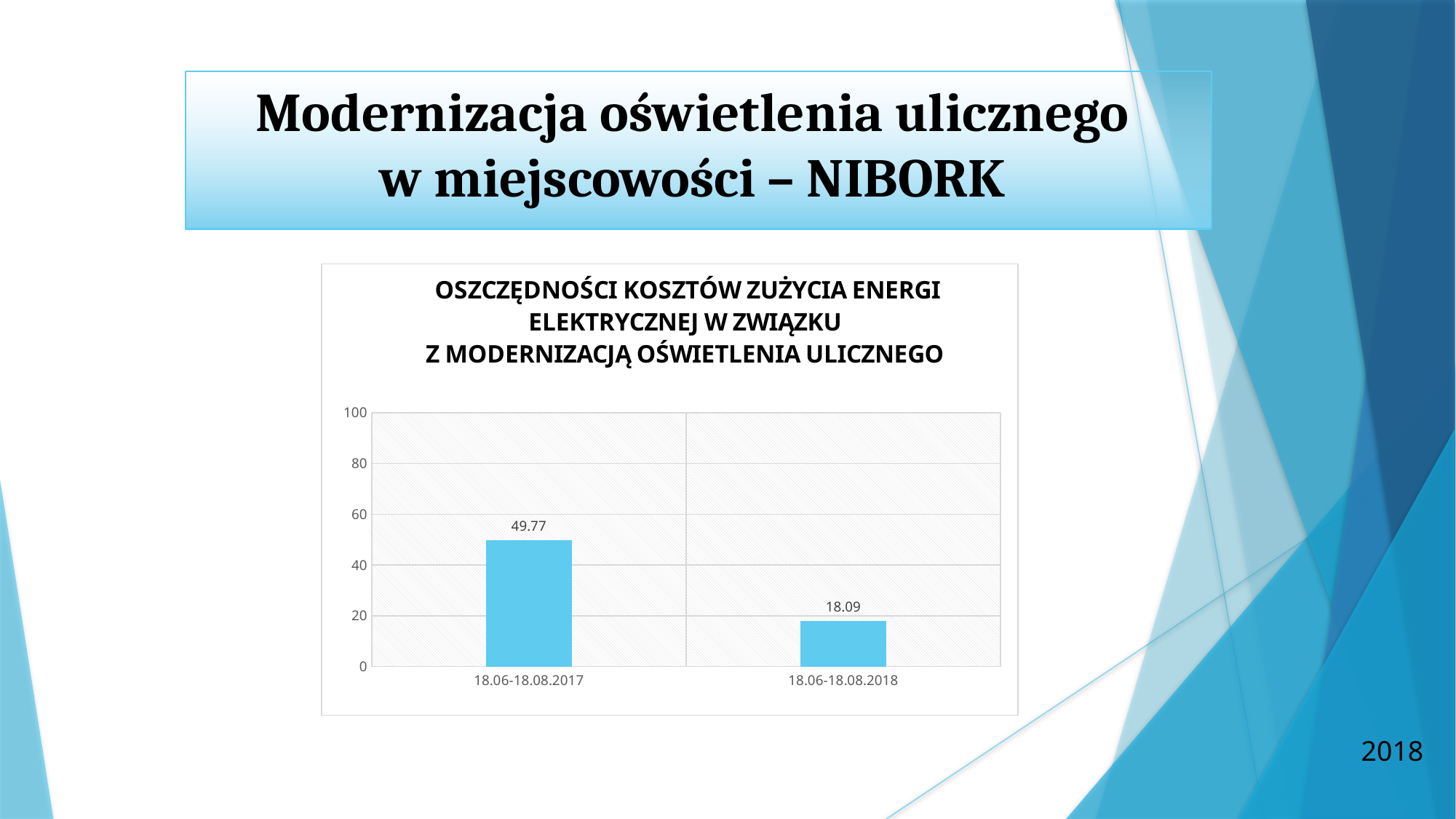
Is the value for 18.06-18.08.2018 greater or less than 20? less What is the difference between the values for 18.06-18.08.2017 and 18.06-18.08.2018? 31.68 Do the values rise or fall from 18.06-18.08.2017 to 18.06-18.08.2018? fall Is the value for 18.06-18.08.2017 greater or less than 40? greater What is the value for 18.06-18.08.2017? 49.77 What is the maximum value shown on the vertical axis? 100 Which category has the lowest value? 18.06-18.08.2018 Which category has the highest value? 18.06-18.08.2017 What kind of chart is shown on the slide? bar chart How many categories are shown on the x axis? 2 Which is larger, the value for 18.06-18.08.2017 or the value for 18.06-18.08.2018? 18.06-18.08.2017 What is the value for 18.06-18.08.2018? 18.09